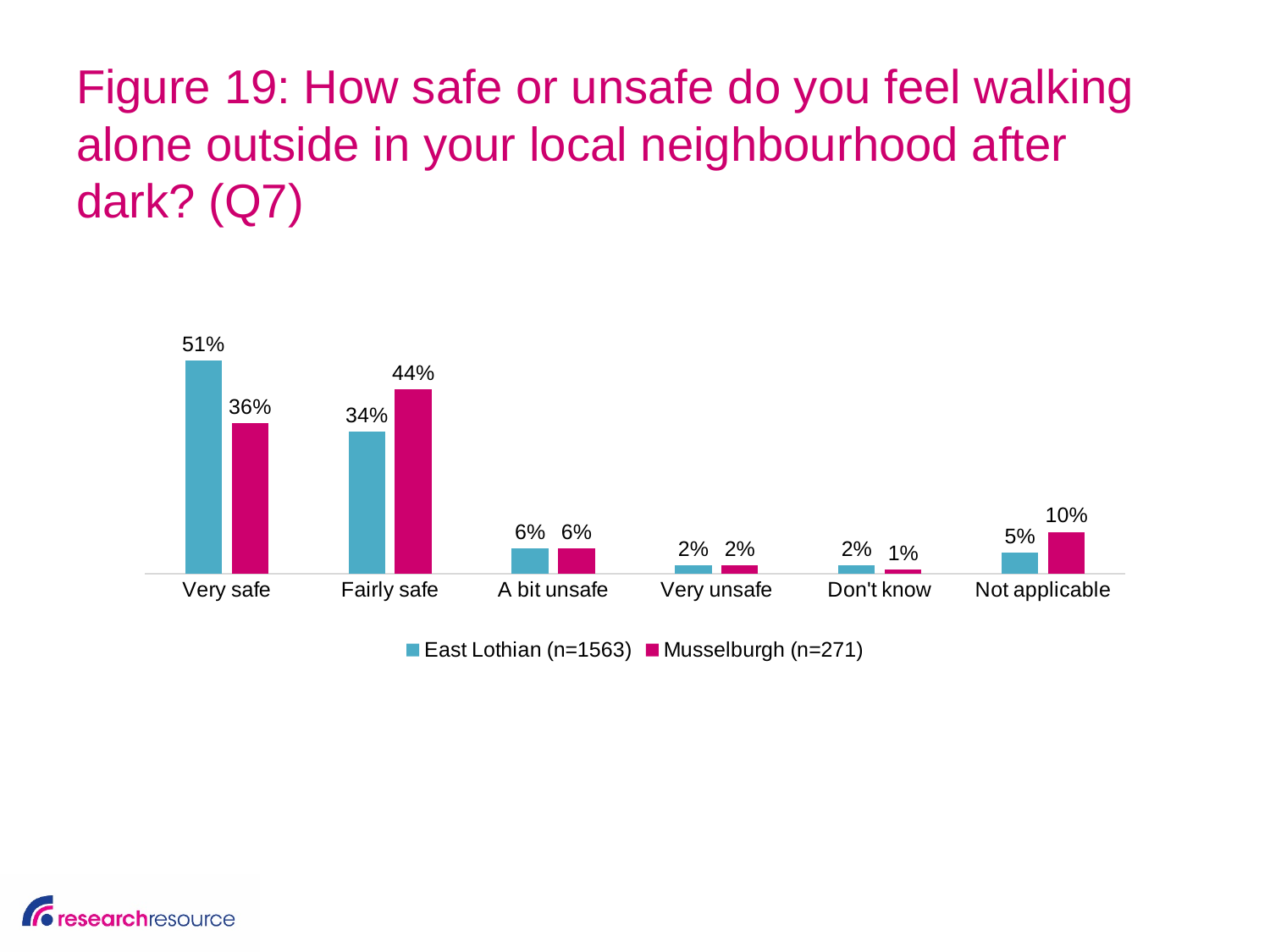
What is the difference between the Musselburgh and East Lothian values for 'Fairly safe'? 10% How many series does the legend list? 2 Which category has the highest value for East Lothian? Very safe What type of chart is shown on the slide? Bar chart What is the East Lothian value for 'Don't know'? 2% What percentage of Musselburgh respondents said they feel fairly safe? 44% How many response categories are shown on the x axis? 6 What is the Musselburgh value for 'Not applicable'? 10% What is the difference between the East Lothian and Musselburgh values for 'Very safe'? 15% For 'Not applicable', which series has the larger value, East Lothian or Musselburgh? Musselburgh Which category has the lowest value for Musselburgh? Don't know What percentage of East Lothian respondents said they feel very safe walking alone after dark? 51%